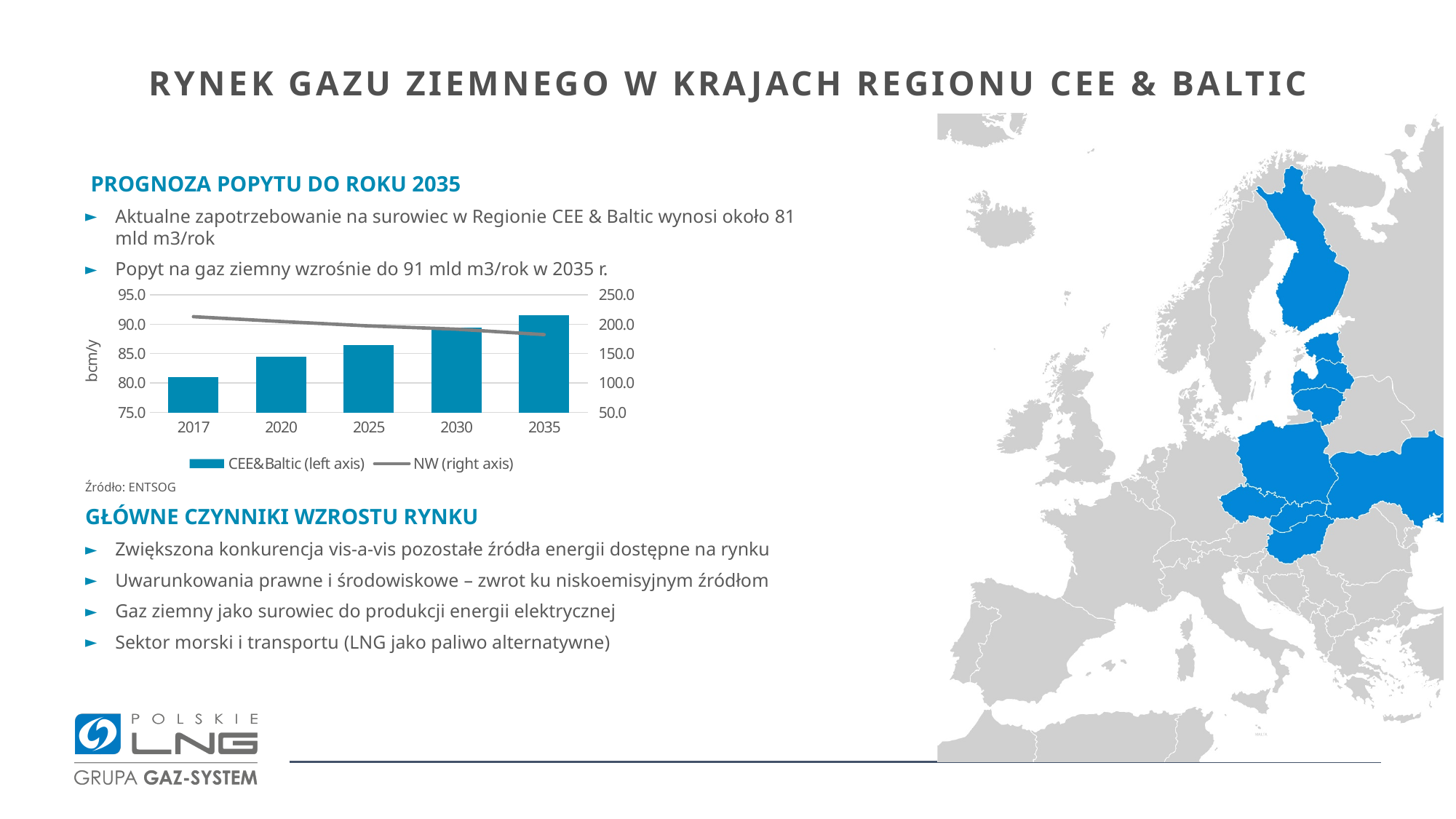
How many years are shown on the x axis of the chart? 5 What kind of chart is shown on the slide? bar chart with a line Which is larger, the CEE&Baltic bar for 2020 or for 2030? 2030 Do the CEE&Baltic bars rise or fall from 2017 to 2035? rise Is the CEE&Baltic value for 2025 greater or less than 85.0? greater Which year has the highest CEE&Baltic bar? 2035 Does the NW (right axis) line rise or fall from 2017 to 2035? fall Which year has the lowest CEE&Baltic bar? 2017 Is the CEE&Baltic value for 2035 greater or less than 90.0? greater What is the label on the left vertical axis of the chart? bcm/y Is the NW (right axis) value for 2017 greater or less than 200.0? greater How many series does the chart legend list? 2